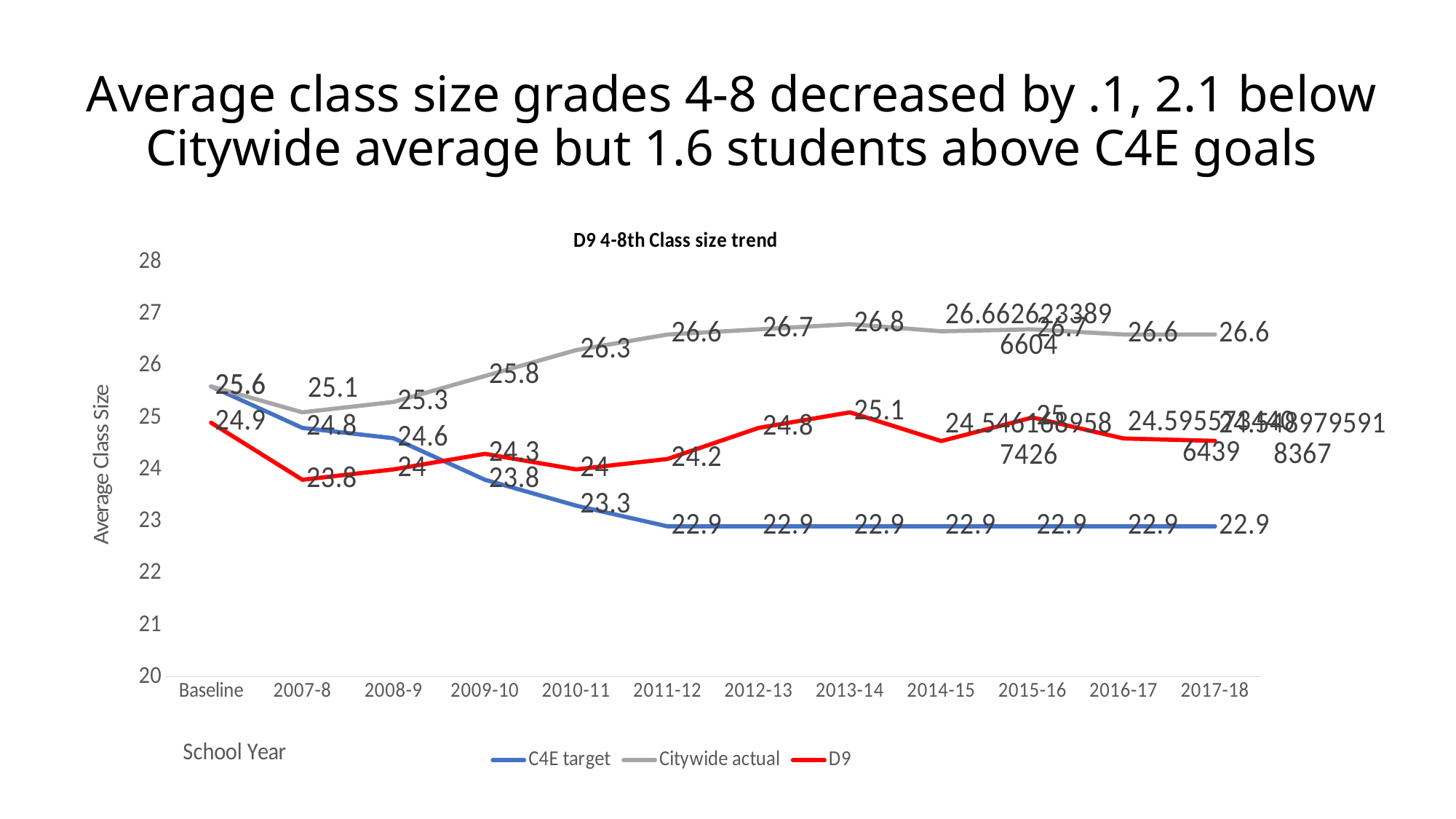
What is the Citywide actual value for 2013-14? 26.8 In which school year is the Citywide actual value highest? 2013-14 What is the D9 value for 2007-8? 23.8 How many school years (categories) are shown on the x axis? 12 What kind of chart is shown on the slide? line chart In 2011-12, which is larger: the Citywide actual value or the D9 value? Citywide actual Does the C4E target line rise or fall from Baseline to 2011-12? fall What is the C4E target value for 2010-11? 23.3 What is the difference between the Citywide actual and D9 values in 2013-14? 1.7 In which school year is the D9 value lowest? 2007-8 What is the C4E target value for 2017-18? 22.9 How many series does the legend list? 3